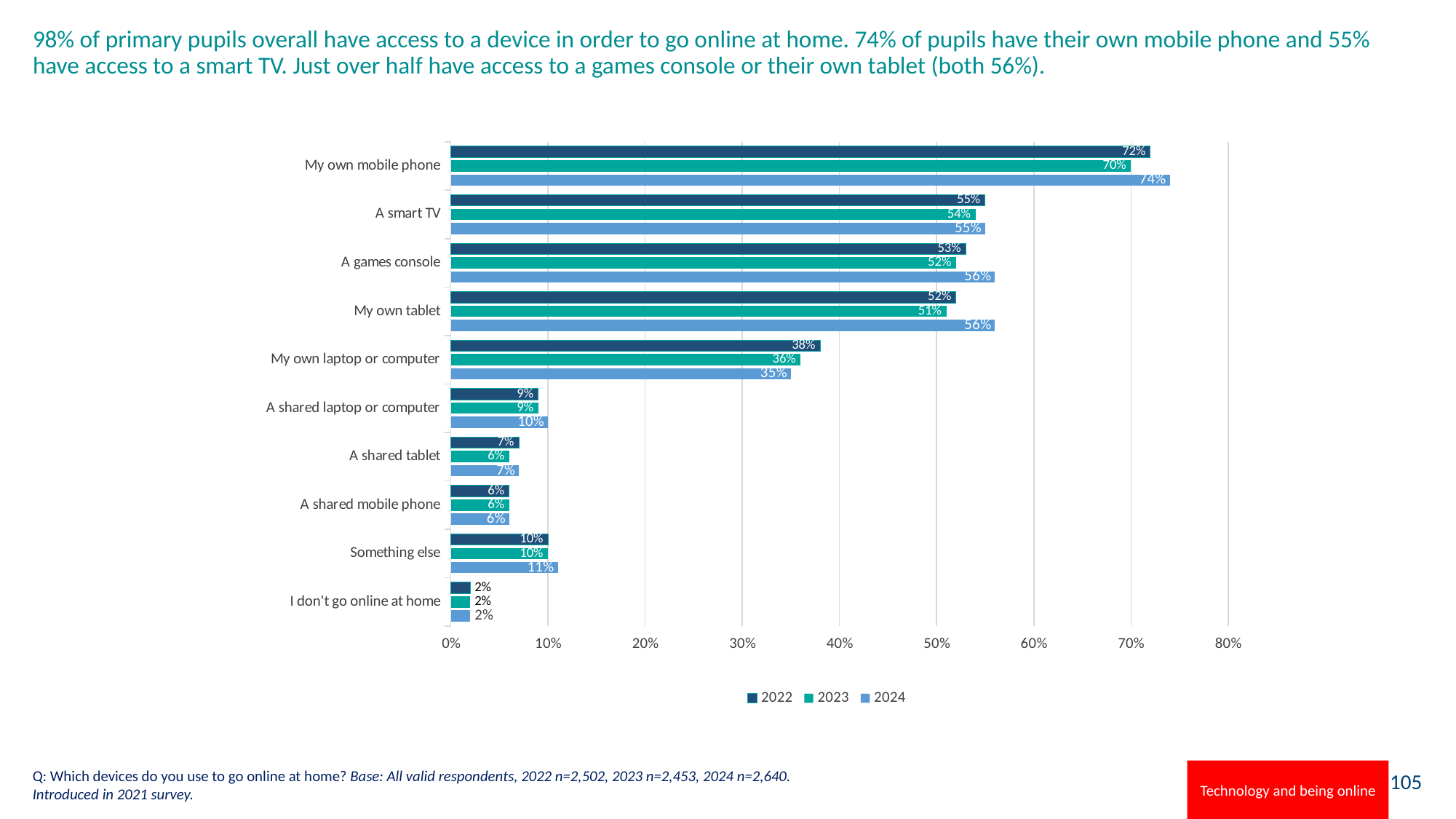
What is the 2024 value for 'Something else'? 11% Which category has the highest 2024 value? My own mobile phone What kind of chart is shown on the slide? Bar chart What is the 2023 value for 'A smart TV'? 54% How many series does the legend list? 3 What is the 2024 value for 'My own mobile phone'? 74% Which years are listed in the legend? 2022, 2023, 2024 How many device categories are shown on the chart? 10 Which is larger for 'A games console': the 2022 value or the 2024 value? 2024 What is the 2022 value for 'My own laptop or computer'? 38% What is the difference between the 2024 and 2023 values for 'My own tablet'? 5% Which category has the lowest 2022 value? I don't go online at home